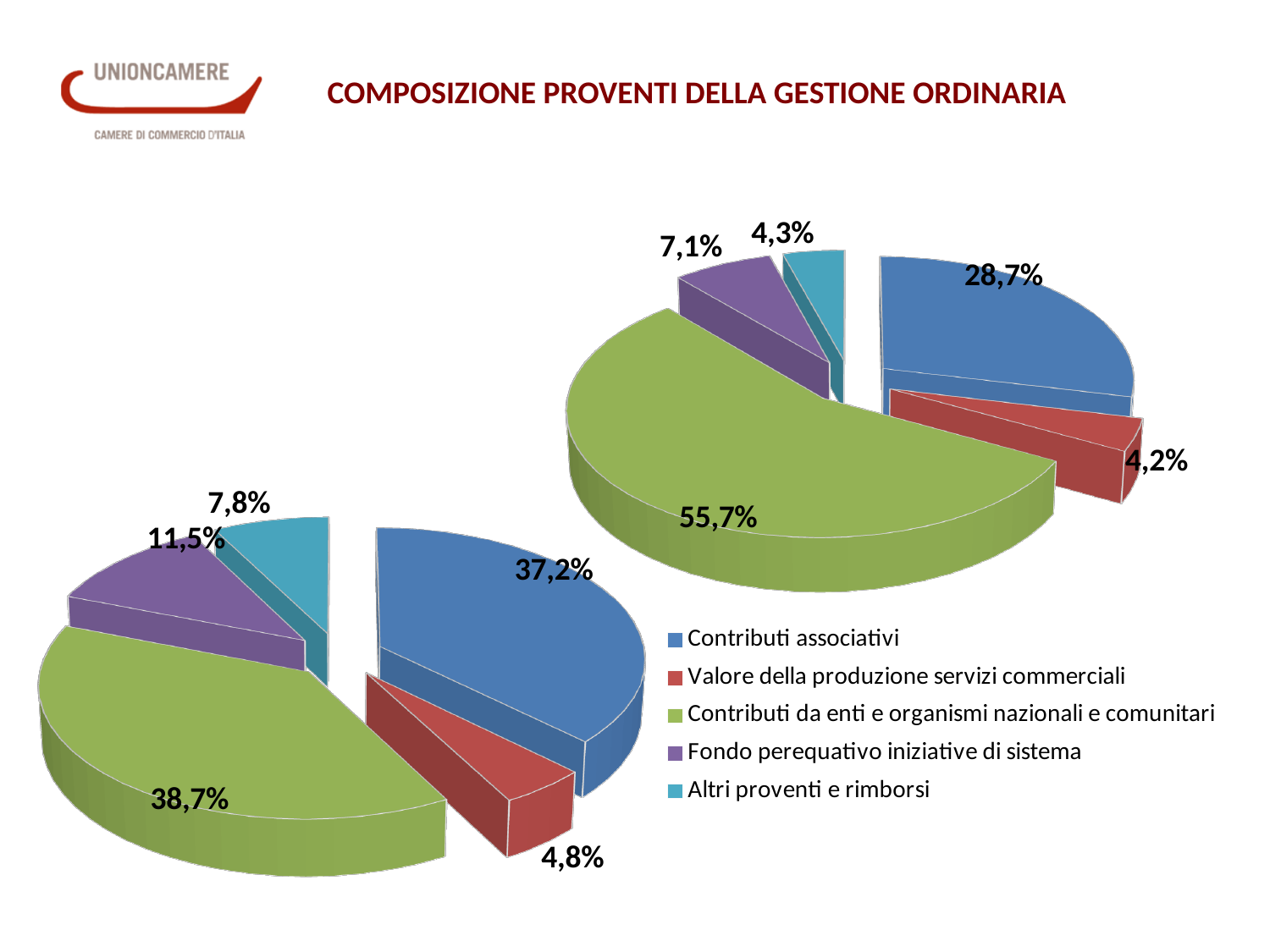
In the upper-right pie chart, what share is shown for Valore della produzione servizi commerciali? 4,2% In the upper-right pie chart, which category has the largest share? Contributi da enti e organismi nazionali e comunitari What is the title of the slide? COMPOSIZIONE PROVENTI DELLA GESTIONE ORDINARIA In the lower-left pie chart, what share is shown for Fondo perequativo iniziative di sistema? 11,5% In the lower-left pie chart, what share is shown for Contributi associativi? 37,2% In the lower-left pie chart, what is the difference between the shares of Contributi associativi and Fondo perequativo iniziative di sistema? 25,7% In the upper-right pie chart, which is larger: the share for Fondo perequativo iniziative di sistema or the share for Altri proventi e rimborsi? Fondo perequativo iniziative di sistema How many categories does the legend list? 5 In the upper-right pie chart, which category has the smallest share? Valore della produzione servizi commerciali What kind of chart is used on this slide? Pie chart In the upper-right pie chart, what share is shown for Contributi da enti e organismi nazionali e comunitari? 55,7% In the lower-left pie chart, which category has the smallest share? Valore della produzione servizi commerciali